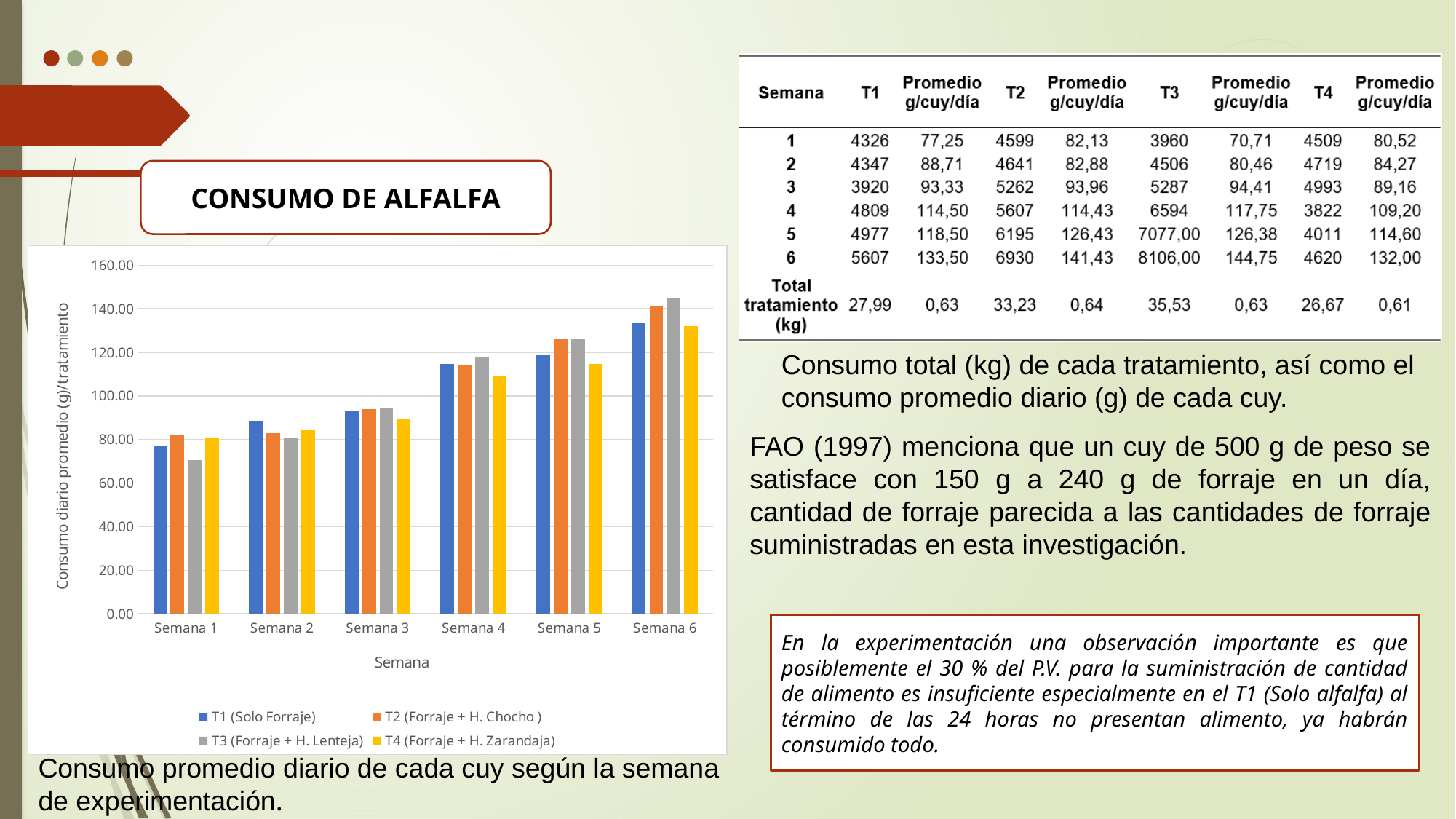
Which treatment has the tallest bar in Semana 6? T3 (Forraje + H. Lenteja) What kind of chart is shown on the slide? bar chart In Semana 1, which treatment has the lowest bar? T3 (Forraje + H. Lenteja) In Semana 5, which is larger: the value for T2 (Forraje + H. Chocho) or T4 (Forraje + H. Zarandaja)? T2 (Forraje + H. Chocho) How many series does the chart legend list? 4 Is the value for T4 (Forraje + H. Zarandaja) in Semana 4 greater or less than 100? greater How many weeks (categories) are shown on the x axis of the chart? 6 Do the values for T1 (Solo Forraje) rise or fall from Semana 1 to Semana 6? rise Which colour represents T4 (Forraje + H. Zarandaja) in the chart? yellow What is the title of the chart's y axis? Consumo diario promedio (g)/tratamiento Is the value for T3 (Forraje + H. Lenteja) in Semana 1 greater or less than 80? less Is the value for T1 (Solo Forraje) in Semana 6 greater or less than 120? greater